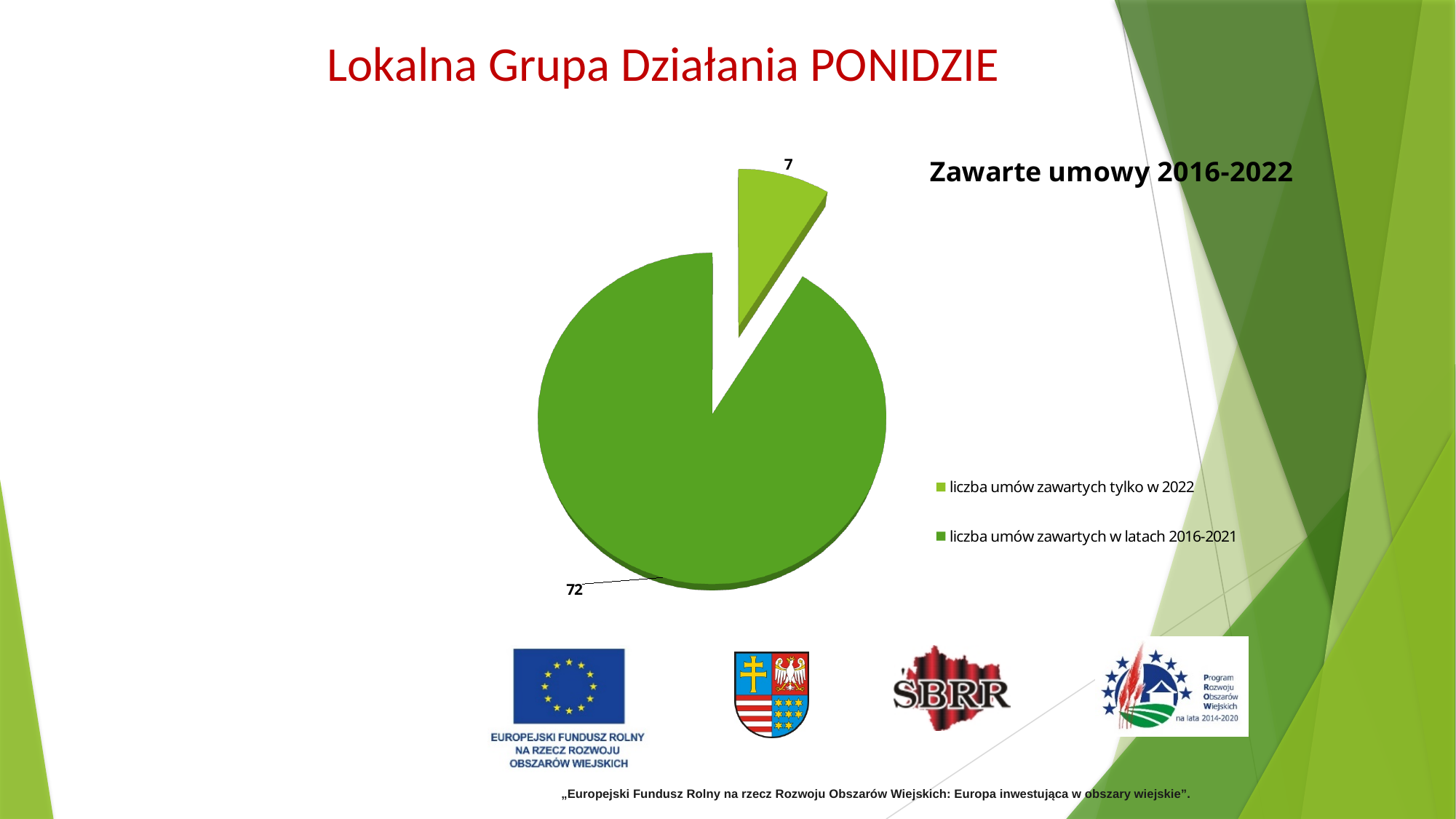
Which slice of the pie chart is the largest? liczba umów zawartych w latach 2016-2021 What is the title of the pie chart? Zawarte umowy 2016-2022 What is the total of the two values shown in the pie chart? 79 What is the value for 'liczba umów zawartych tylko w 2022'? 7 How many entries does the legend of the pie chart list? 2 Which is larger: the number of contracts concluded only in 2022 or the number concluded in 2016-2021? liczba umów zawartych w latach 2016-2021 How many slices does the pie chart have? 2 What is the value for 'liczba umów zawartych w latach 2016-2021'? 72 Which slice of the pie chart is the smallest? liczba umów zawartych tylko w 2022 What is the difference between the number of contracts concluded in 2016-2021 and those concluded only in 2022? 65 What kind of chart is shown on the slide? pie chart Which legend entry is shown in the lighter green colour? liczba umów zawartych tylko w 2022